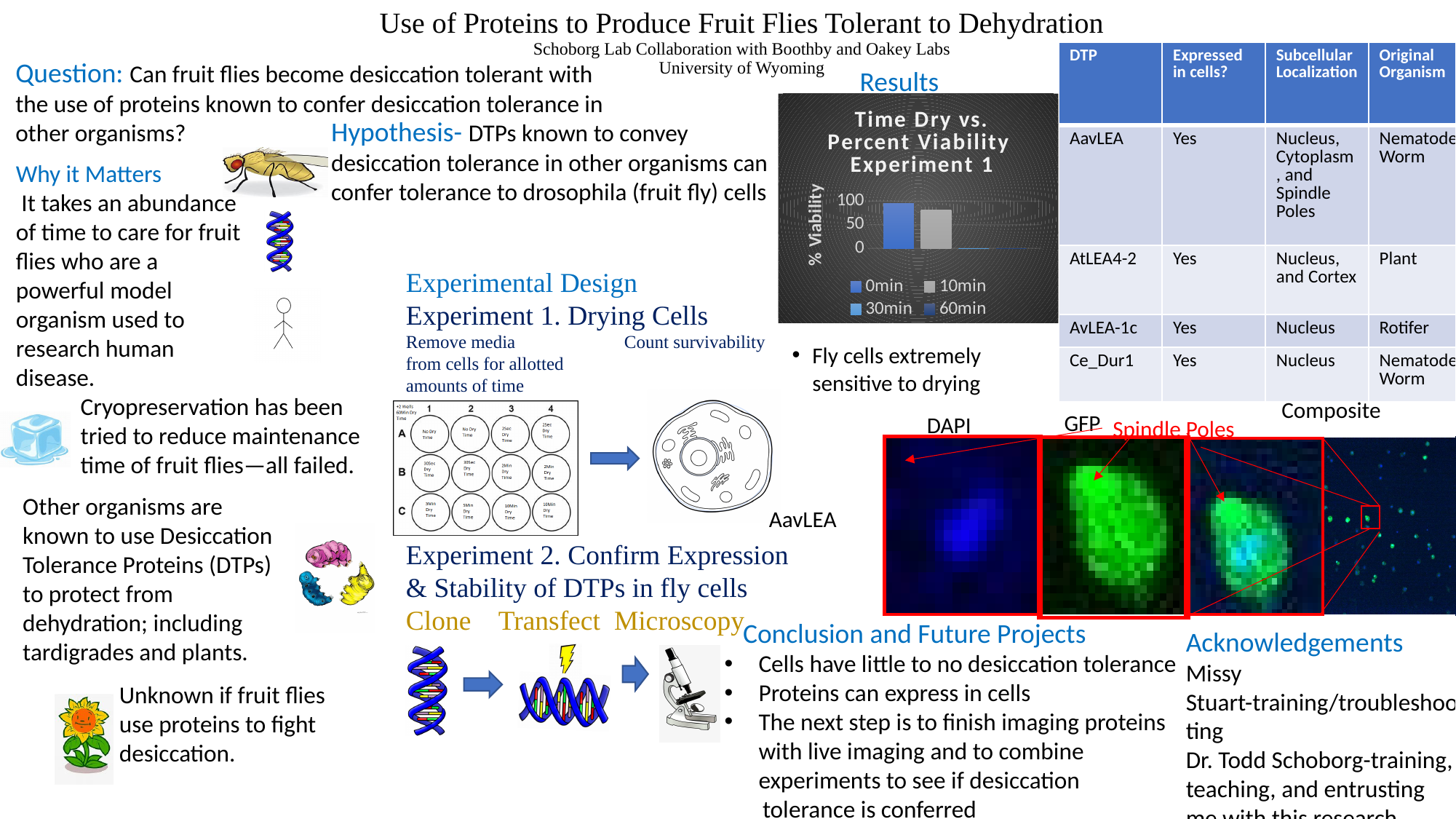
What is the label on the vertical axis of the "Time Dry vs. Percent Viability Experiment 1" chart? % Viability How many series does the legend of the "Time Dry vs. Percent Viability Experiment 1" chart list? 4 In the "Time Dry vs. Percent Viability Experiment 1" chart, is the % Viability for 0min greater or less than 50? greater In the "Time Dry vs. Percent Viability Experiment 1" chart, which series has the tallest bar? 0min What is the title of the chart in the Results section? Time Dry vs. Percent Viability Experiment 1 In the "Time Dry vs. Percent Viability Experiment 1" chart, is the bar for 0min taller or shorter than the bar for 10min? taller What is the highest tick value shown on the vertical axis of the "Time Dry vs. Percent Viability Experiment 1" chart? 100 What kind of chart is the "Time Dry vs. Percent Viability Experiment 1" chart? bar chart In the "Time Dry vs. Percent Viability Experiment 1" chart, is the % Viability for 10min greater or less than 50? greater In the "Time Dry vs. Percent Viability Experiment 1" chart, does % Viability rise or fall as the drying time increases from 0min to 10min? fall